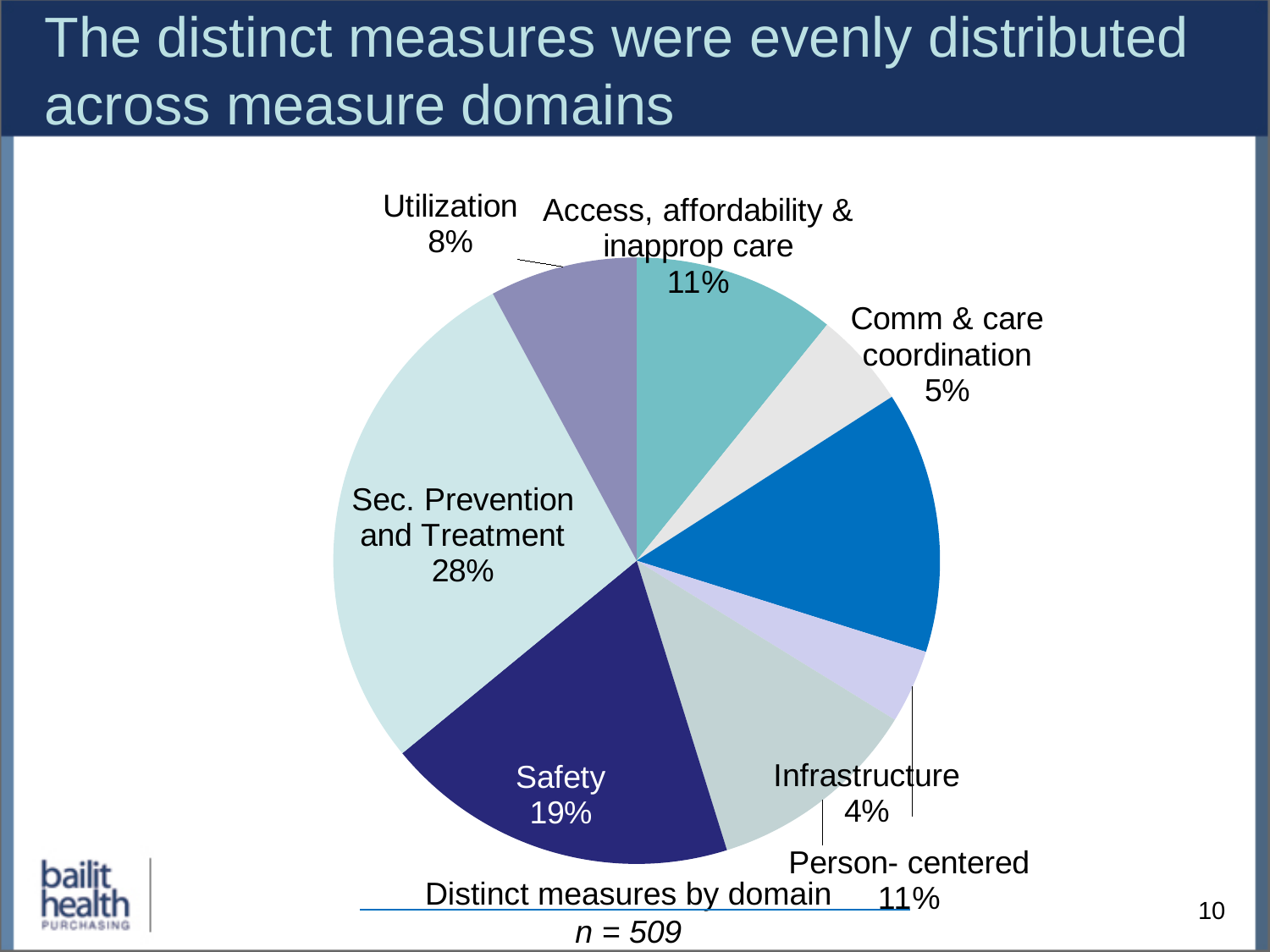
What percentage is shown for Comm & care coordination? 5% What type of chart is shown on the slide? pie chart Which labeled domain has the largest share of the pie? Sec. Prevention and Treatment What percentage is shown for Infrastructure? 4% What share of the pie is Sec. Prevention and Treatment? 28% What percentage is shown for Utilization? 8% What percentage of distinct measures falls in the Safety domain? 19% What is the difference in percentage points between Safety and Utilization? 11 Which has a larger share, Safety or Access, affordability & inapprop care? Safety What is the title of the pie chart? Distinct measures by domain Which labeled domain has the smallest share of the pie? Infrastructure What is the value of n shown below the chart title? n = 509